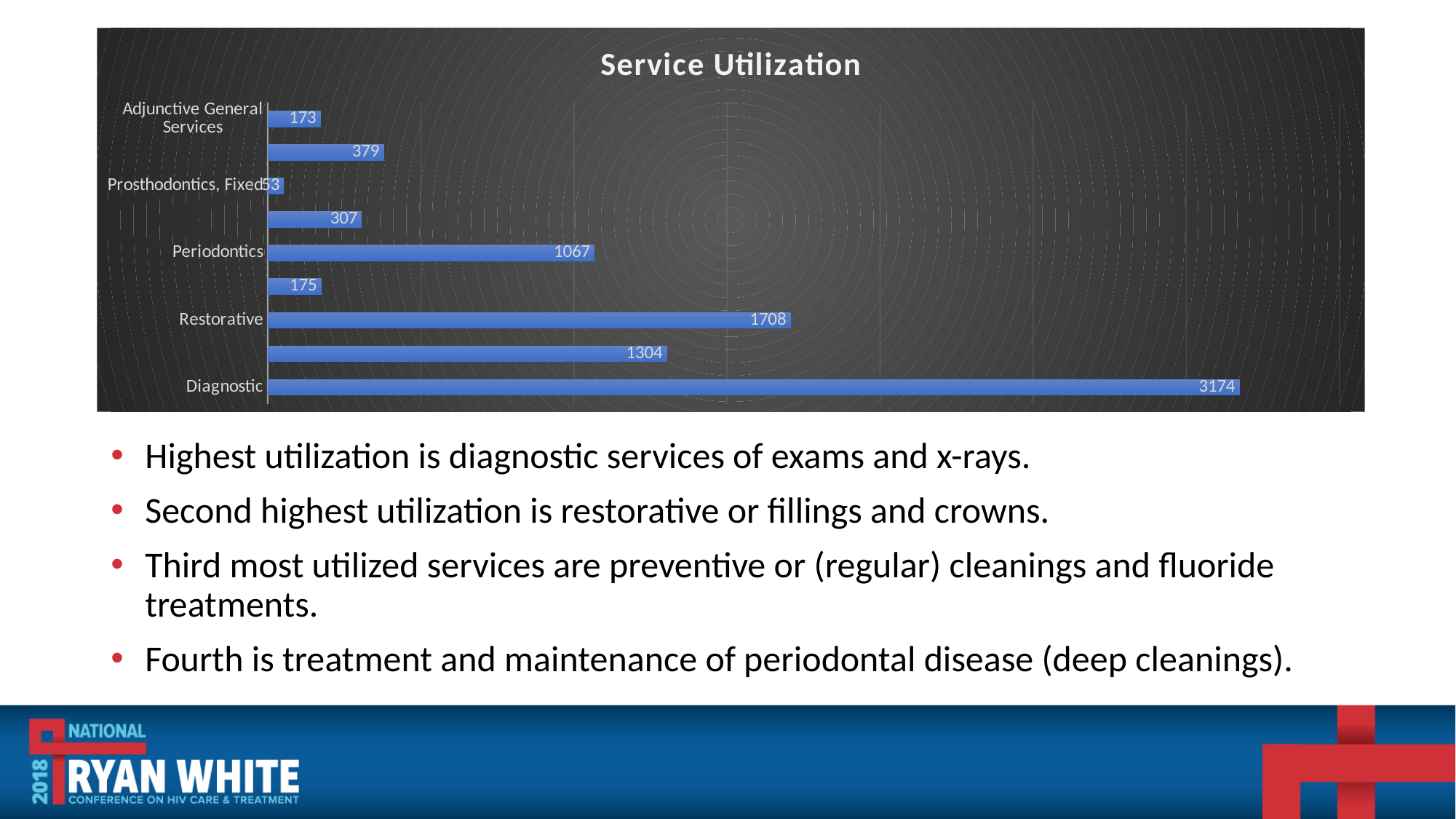
What is the difference between the values for Diagnostic and Restorative? 1466 Which category has the lowest value in the Service Utilization chart? Prosthodontics, Fixed What kind of chart is shown on the slide? Bar chart What is the difference between the values for Restorative and Periodontics? 641 What is the value for Diagnostic in the Service Utilization chart? 3174 How many bars are plotted in the Service Utilization chart? 9 Which is larger, the value for Periodontics or the value for Restorative? Restorative What is the value for Prosthodontics, Fixed in the Service Utilization chart? 53 Which category has the highest value in the Service Utilization chart? Diagnostic What is the value for Adjunctive General Services in the Service Utilization chart? 173 What is the value for Periodontics in the Service Utilization chart? 1067 What is the value for Restorative in the Service Utilization chart? 1708